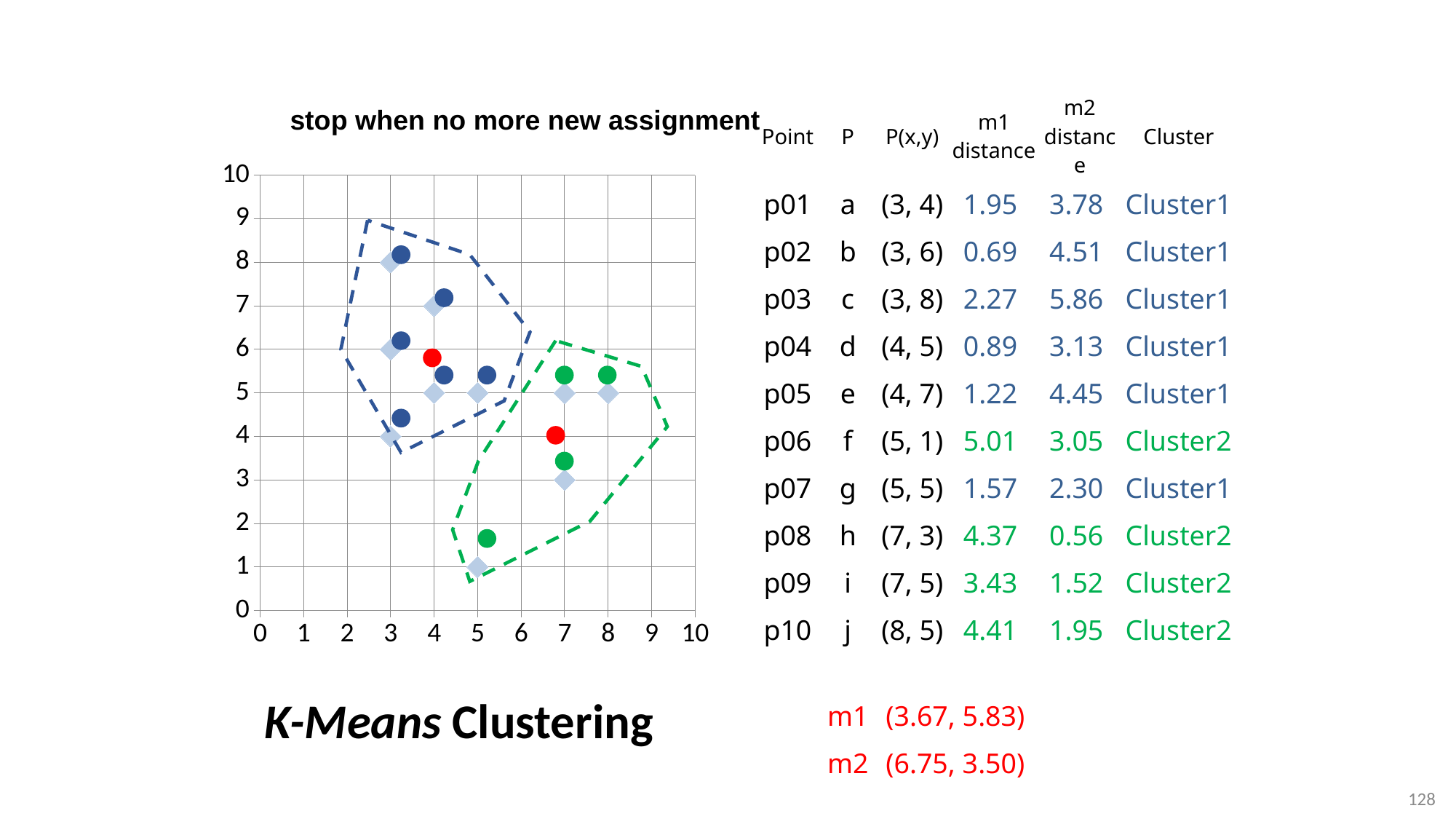
What is the difference in y value between point c (3, 8) and point f (5, 1)? 7 What are the coordinates of the centroid m1? (3.67, 5.83) What are the coordinates of the centroid m2? (6.75, 3.50) How many points are assigned to Cluster2 (green circles) on the chart? 4 What is the title printed above the chart? stop when no more new assignment What kind of chart is shown on the slide? scatter chart Which point has the lowest y value on the chart? f (5, 1) Which point has the largest x value on the chart? j (8, 5) How many data points (light-blue diamonds) are plotted on the chart? 10 Is the x coordinate of centroid m2 greater or less than 6? greater What are the coordinates of point a (p01)? (3, 4) Which point has the highest y value on the chart? c (3, 8)